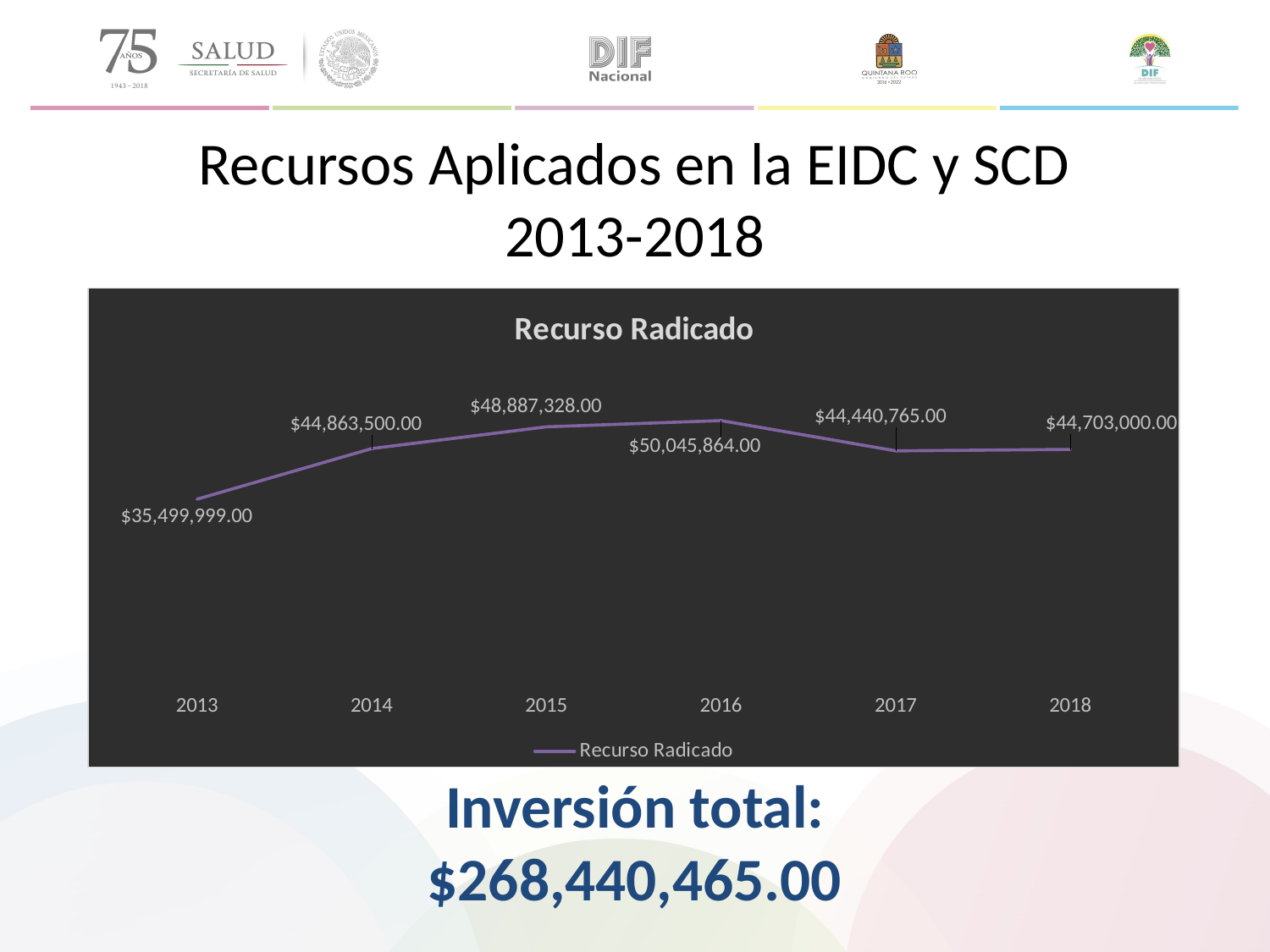
What is the value for 2013 in the Recurso Radicado chart? $35,499,999.00 Does the value in the Recurso Radicado chart rise or fall from 2013 to 2016? Rise What is the difference between the 2016 and 2013 values in the Recurso Radicado chart? $14,545,865.00 Which year has the larger value in the Recurso Radicado chart, 2017 or 2018? 2018 What is the value for 2018 in the Recurso Radicado chart? $44,703,000.00 What is the value for 2016 in the Recurso Radicado chart? $50,045,864.00 What is the difference between the 2014 and 2013 values in the Recurso Radicado chart? $9,363,501.00 What is the value for 2015 in the Recurso Radicado chart? $48,887,328.00 How many years are plotted in the Recurso Radicado chart? 6 Which year has the highest value in the Recurso Radicado chart? 2016 Which year has the lowest value in the Recurso Radicado chart? 2013 What kind of chart is the Recurso Radicado chart? Line chart